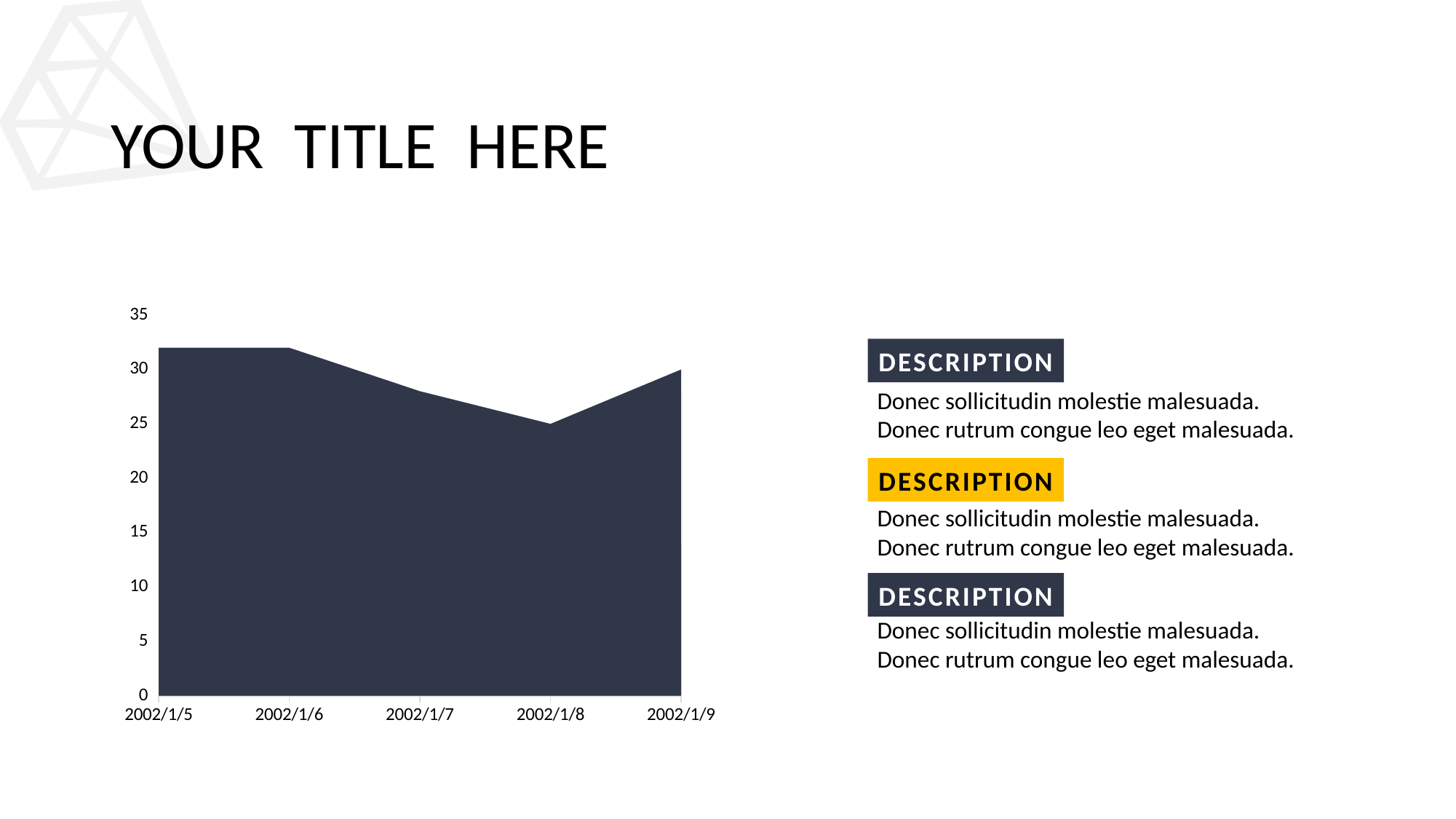
Is the value for 2002/1/9 greater or less than 25? greater Which is larger, the value for 2002/1/5 or the value for 2002/1/8? 2002/1/5 What is the highest value shown on the chart's vertical axis? 35 What kind of chart is shown on the slide? Area chart Which date has the lowest value in the chart? 2002/1/8 Is the value for 2002/1/7 greater or less than 25? greater Is the value for 2002/1/7 greater or less than 30? less Do the values rise or fall from 2002/1/6 to 2002/1/8? fall Which is larger, the value for 2002/1/7 or the value for 2002/1/9? 2002/1/9 How many dates are plotted along the x axis of the chart? 5